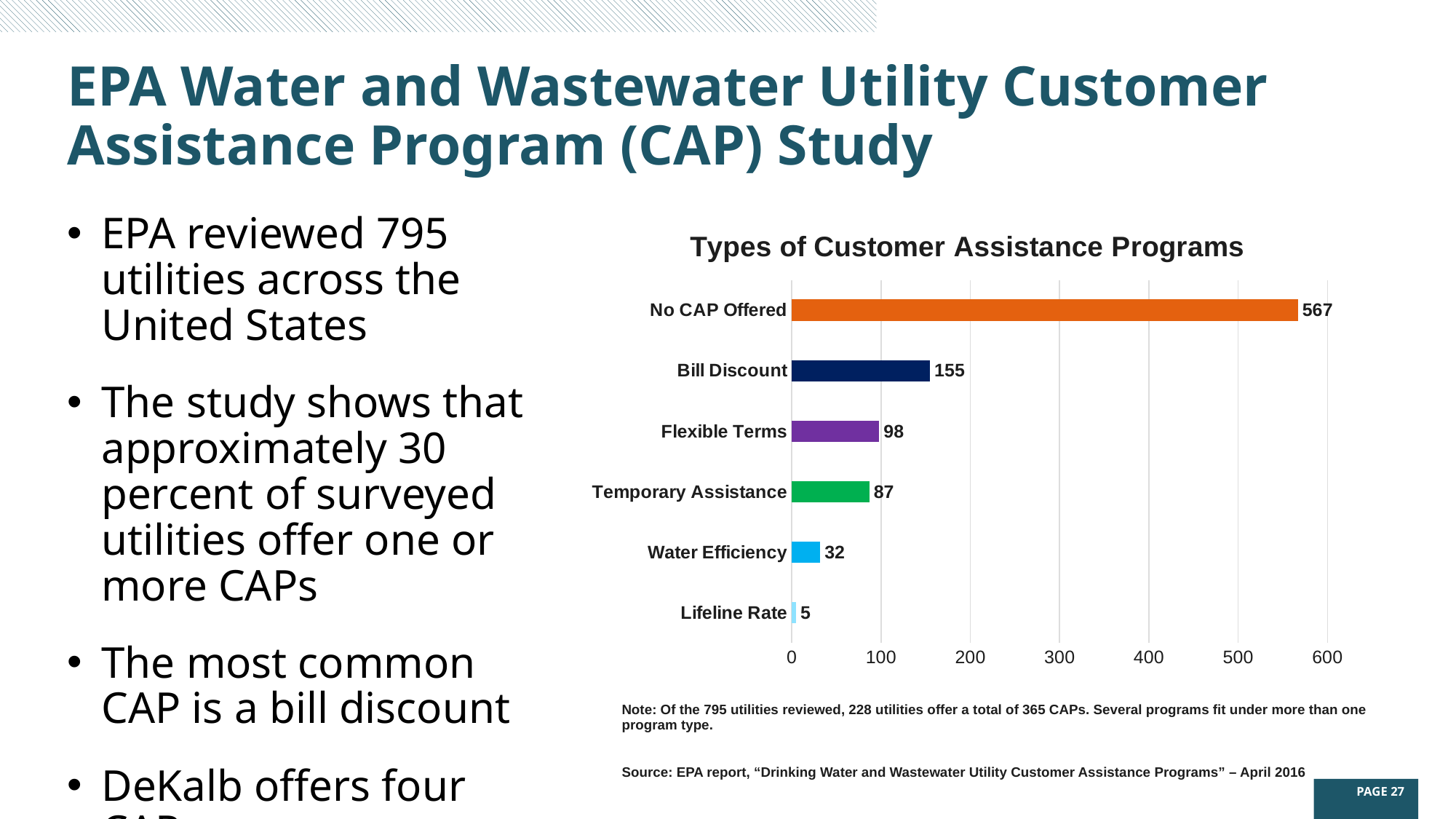
How many categories are shown in the chart? 6 What is the value for Bill Discount? 155 Which category has the lowest value? Lifeline Rate What kind of chart is shown on the slide? bar chart What is the value for No CAP Offered? 567 Which is larger, the value for Flexible Terms or the value for Water Efficiency? Flexible Terms What is the value for Lifeline Rate? 5 What is the value for Temporary Assistance? 87 What is the title of the chart? Types of Customer Assistance Programs What is the difference between the values for Bill Discount and Flexible Terms? 57 Which category has the highest value? No CAP Offered Is the value for Temporary Assistance greater or less than 100? less